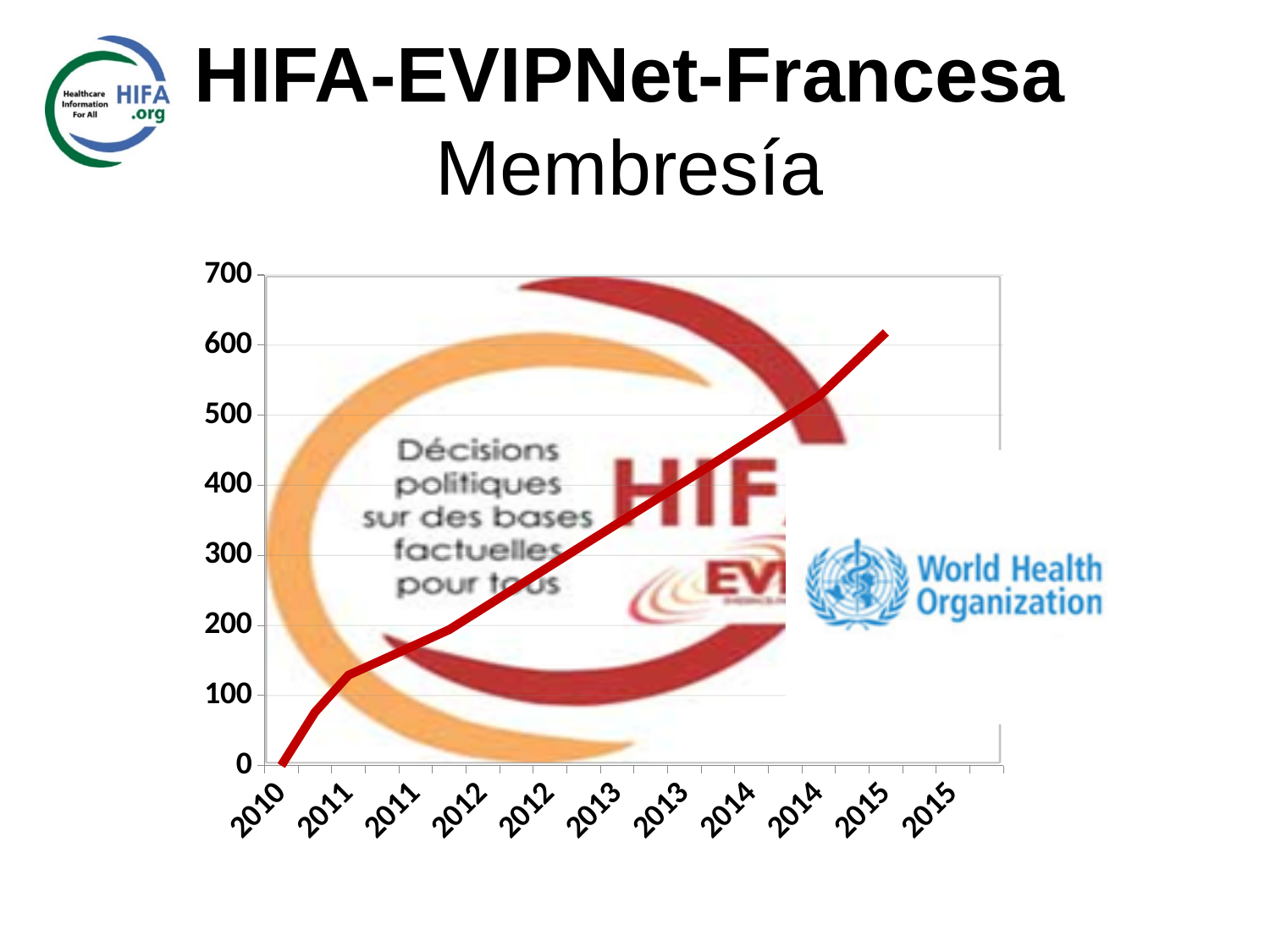
How many labels are shown along the x axis of the chart? 11 Do the values on the chart rise or fall from 2010 to 2015? rise What is the value plotted at 2010, the first point on the chart? 0 Is the value at the first 2011 tick greater or less than 100? greater What colour is the line plotted on the chart? red What is the highest value shown on the y axis of the chart? 700 What kind of chart is shown on the slide? line chart Is the value at the last plotted point (2015) greater or less than 500? greater Is the value at the second 2014 tick greater or less than 500? greater Which is larger, the value at the first 2012 tick or the value at the first 2014 tick? 2014 Which x-axis label has the lowest value on the chart? 2010